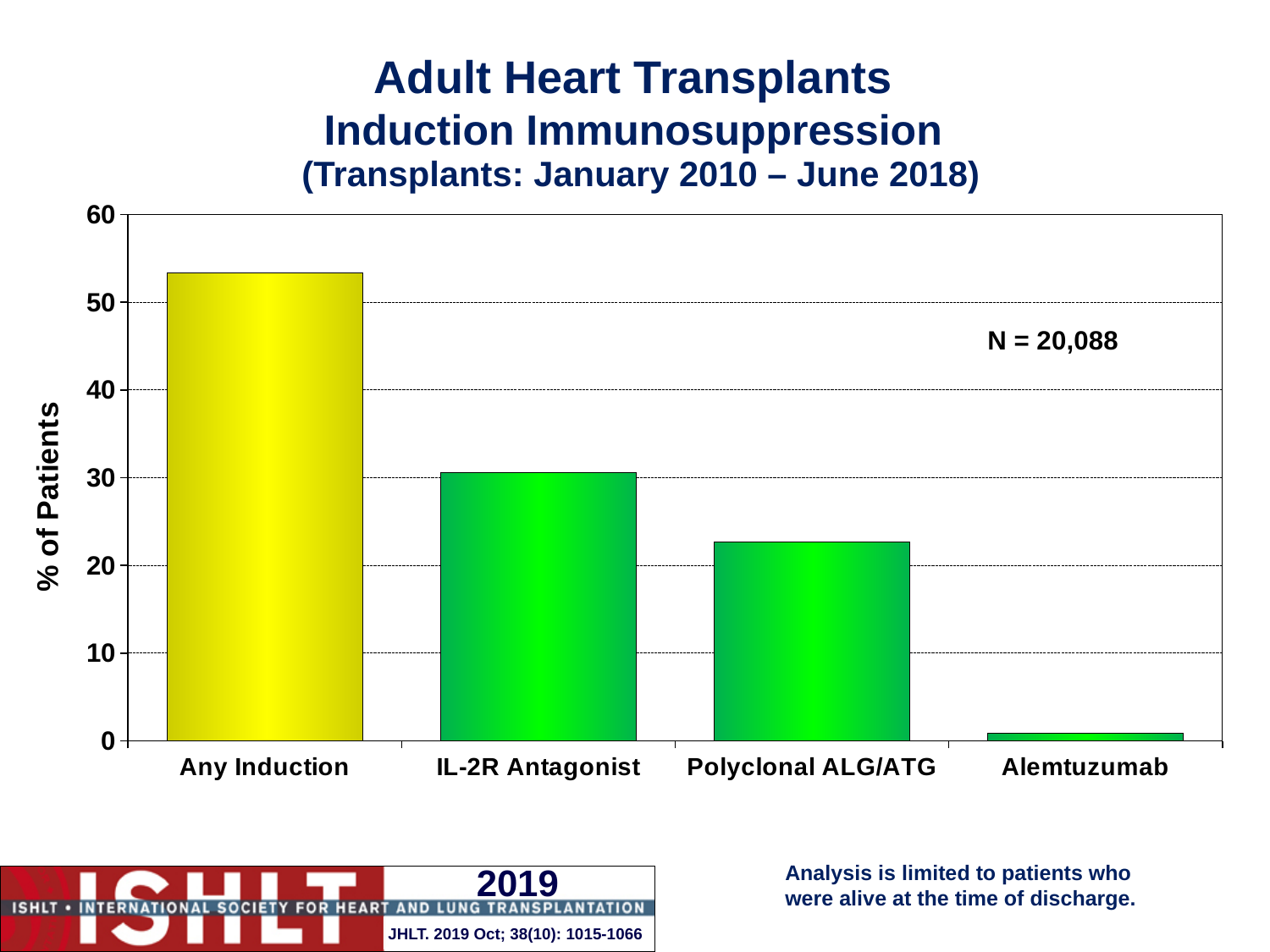
Which category has the lowest % of patients? Alemtuzumab Do the bar values rise or fall from left to right along the x axis? fall What kind of chart is shown on the slide? bar chart Is the value for Polyclonal ALG/ATG greater or less than 20? greater What is the N value shown on the chart? N = 20,088 What is the label of the y axis? % of Patients How many categories are shown on the x axis of the chart? 4 Is the value for Alemtuzumab greater or less than 10? less Which is larger, the value for IL-2R Antagonist or the value for Polyclonal ALG/ATG? IL-2R Antagonist Is the value for IL-2R Antagonist greater or less than 40? less Which category has the highest % of patients? Any Induction